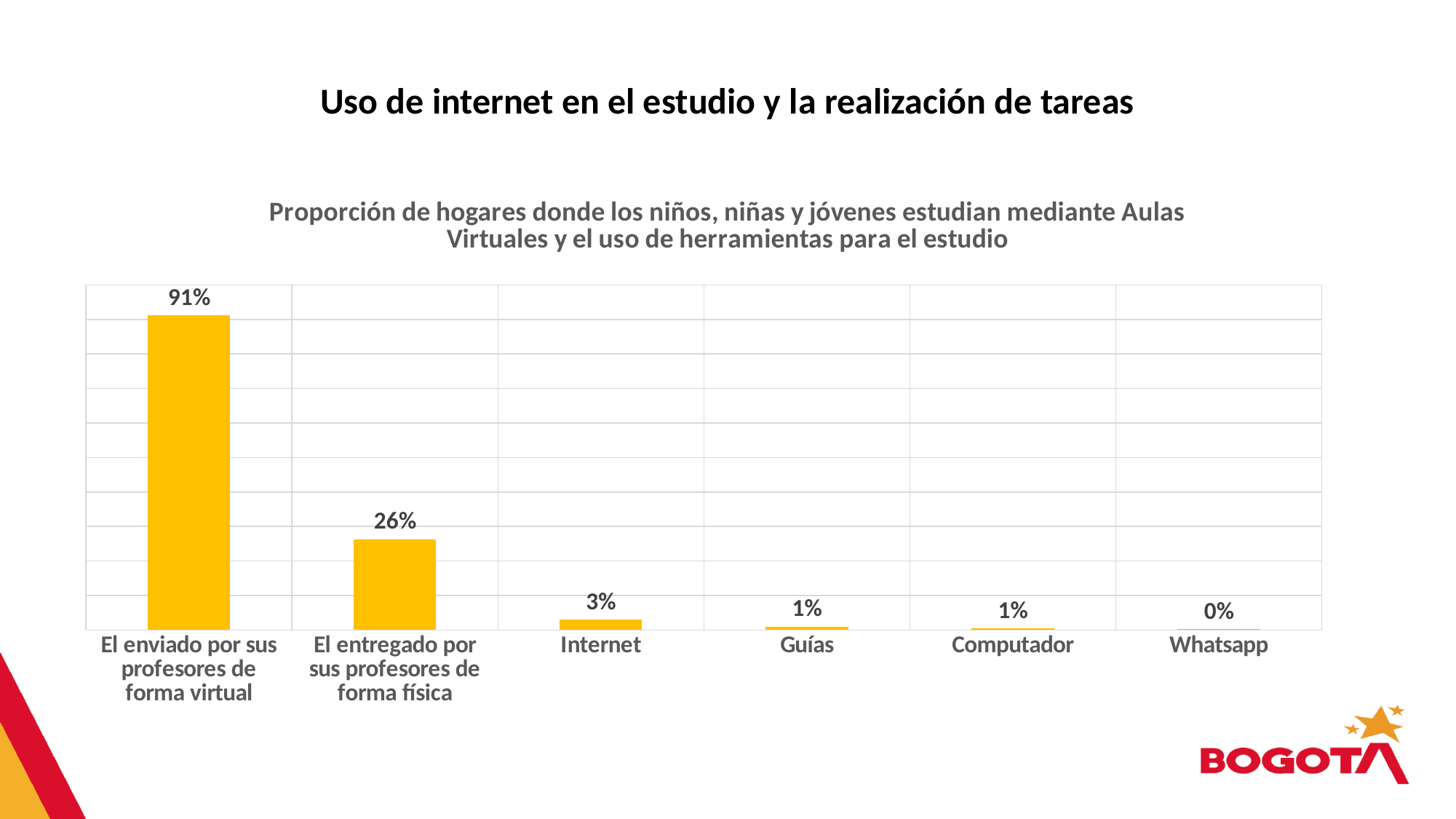
What is the value for "El entregado por sus profesores de forma física"? 26% Which category has the highest value? El enviado por sus profesores de forma virtual Which is larger, the value for Internet or the value for Computador? Internet What is the value for Internet? 3% What is the value for Whatsapp? 0% Which category has the lowest value? Whatsapp What is the difference between the values for "El enviado por sus profesores de forma virtual" and "El entregado por sus profesores de forma física"? 65% What is the title of the chart? Proporción de hogares donde los niños, niñas y jóvenes estudian mediante Aulas Virtuales y el uso de herramientas para el estudio What is the value for "El enviado por sus profesores de forma virtual"? 91% How many categories are shown on the x axis? 6 What is the difference between the values for Internet and Guías? 2% What kind of chart is this? Bar chart